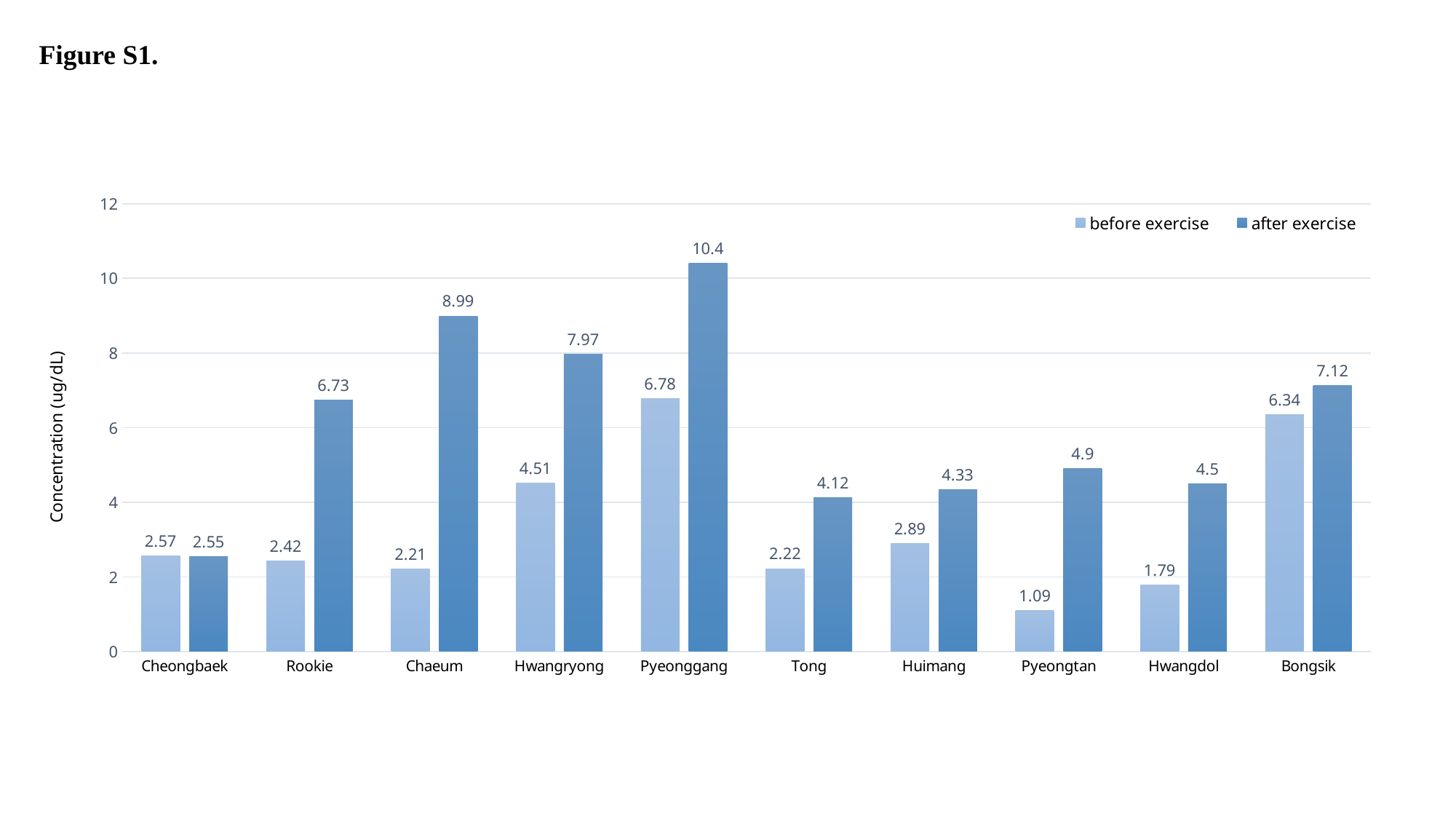
How many series does the legend list? 2 How many categories are shown on the x axis? 10 What is the 'after exercise' concentration for Pyeonggang? 10.4 What is the 'before exercise' value for Pyeongtan? 1.09 Which category has the highest 'after exercise' value? Pyeonggang Which is larger for Cheongbaek: the 'before exercise' value or the 'after exercise' value? before exercise Which category has the lowest 'before exercise' value? Pyeongtan What kind of chart is shown on the slide? bar chart Is the 'after exercise' value for Bongsik greater or less than 6? greater What is the difference between the 'after exercise' and 'before exercise' values for Chaeum? 6.78 What is the label of the y axis? Concentration (ug/dL) What is the 'before exercise' concentration for Hwangryong? 4.51